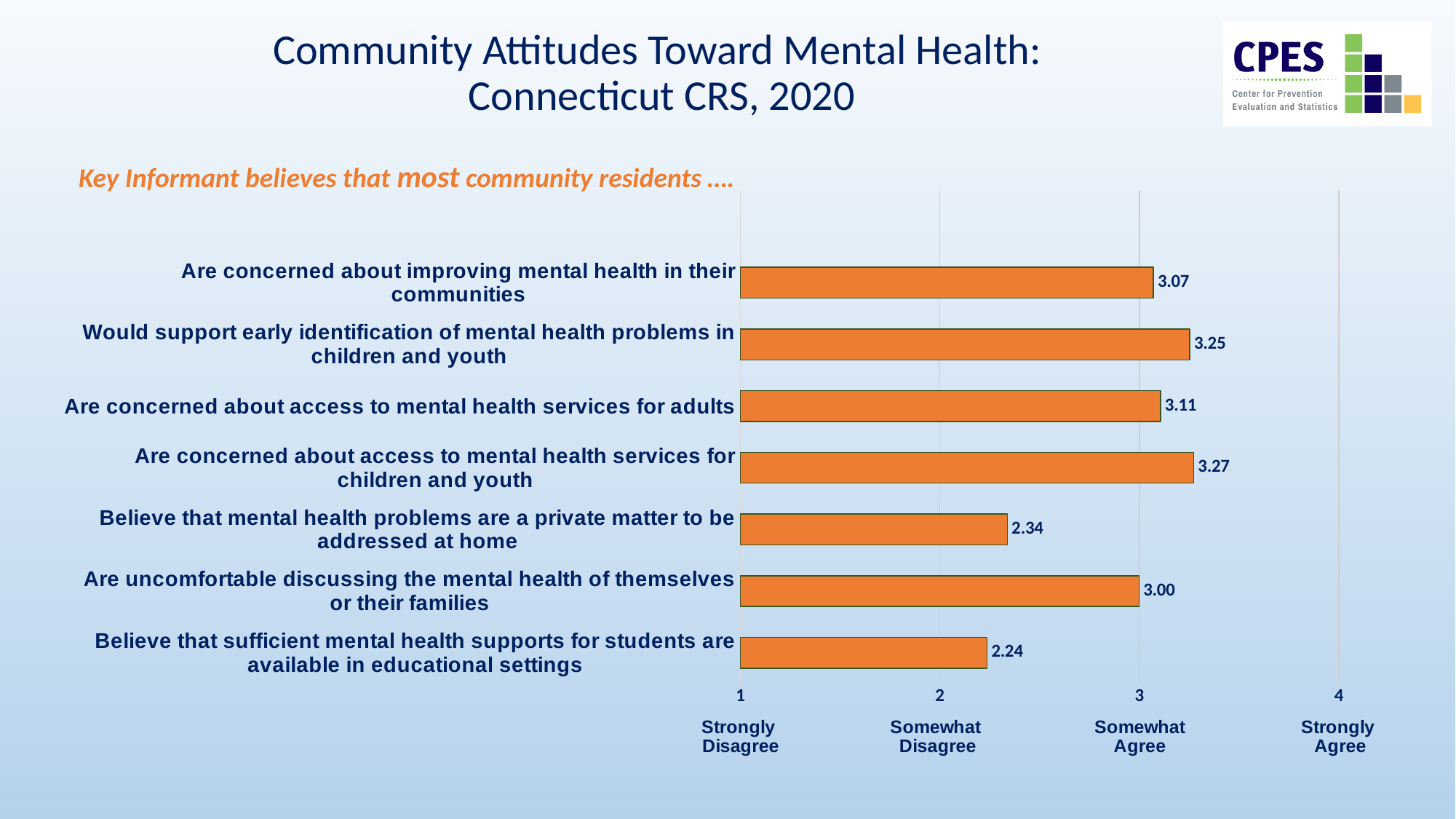
What is the value for 'Are concerned about improving mental health in their communities'? 3.07 What label does the x axis show at the value 4? Strongly Agree What colour are the bars in the chart? orange Which category has the lowest value? Believe that sufficient mental health supports for students are available in educational settings Which is larger: the value for 'Are concerned about access to mental health services for adults' or the value for 'Are concerned about improving mental health in their communities'? Are concerned about access to mental health services for adults What is the value for 'Are uncomfortable discussing the mental health of themselves or their families'? 3.00 What is the difference between the values for 'Would support early identification of mental health problems in children and youth' and 'Believe that mental health problems are a private matter to be addressed at home'? 0.91 What kind of chart is shown on the slide? bar chart What is the value for 'Believe that sufficient mental health supports for students are available in educational settings'? 2.24 Is the value for 'Believe that mental health problems are a private matter to be addressed at home' greater or less than 3? less How many categories are shown in the chart? 7 Which category has the highest value? Are concerned about access to mental health services for children and youth